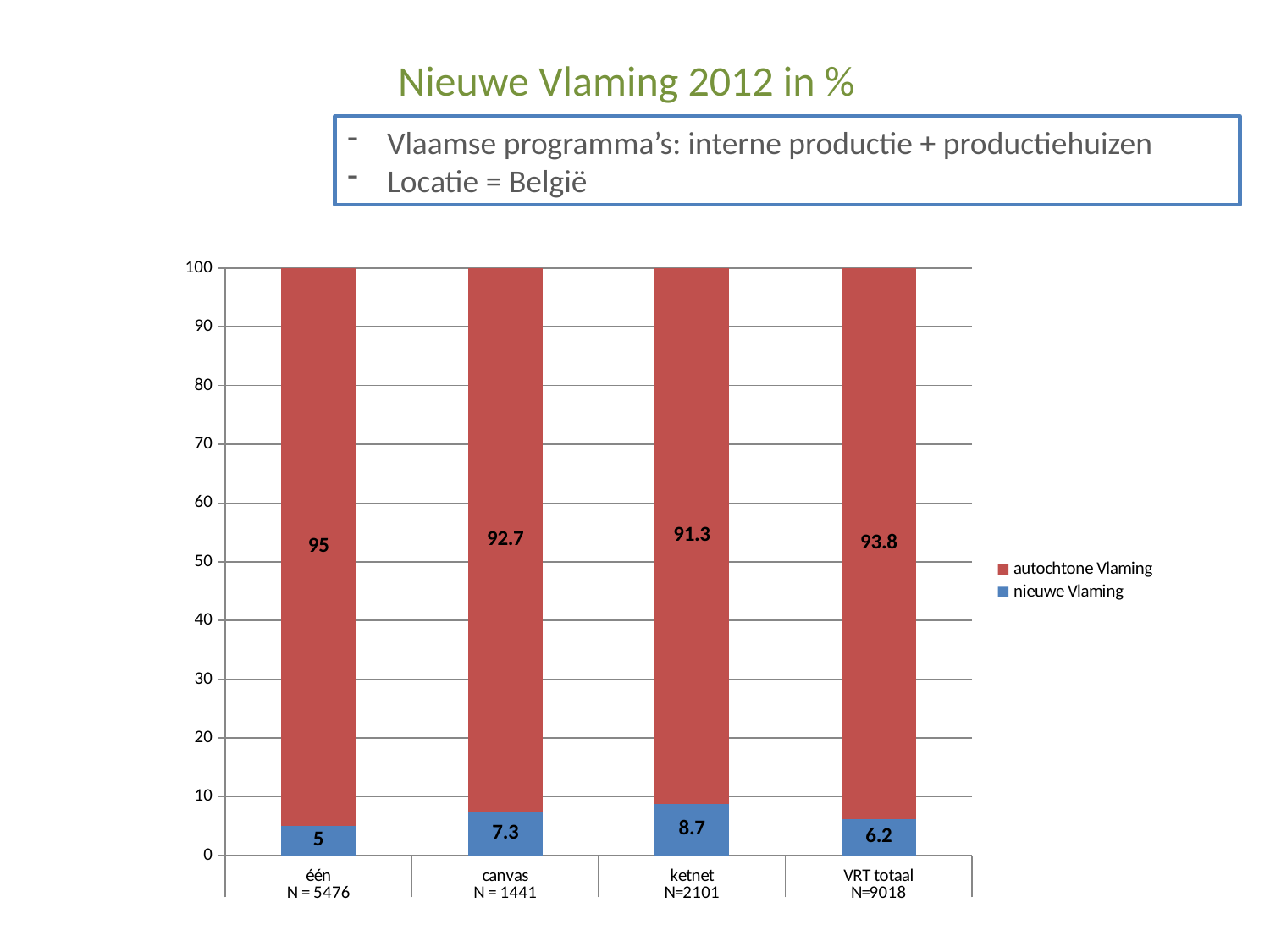
What is the value for nieuwe Vlaming for VRT totaal? 6.2 What kind of chart is shown on the slide? stacked bar chart What is the title of the slide? Nieuwe Vlaming 2012 in % What is the difference between the nieuwe Vlaming values for ketnet and één? 3.7 Which is larger, the nieuwe Vlaming value for canvas or for VRT totaal? canvas What is the value for nieuwe Vlaming for ketnet? 8.7 What is the total of the stacked bar for één? 100 Which category has the lowest value for autochtone Vlaming? ketnet Which category has the highest value for nieuwe Vlaming? ketnet How many series does the legend list? 2 How many categories are shown on the x axis? 4 What is the value for autochtone Vlaming for canvas? 92.7